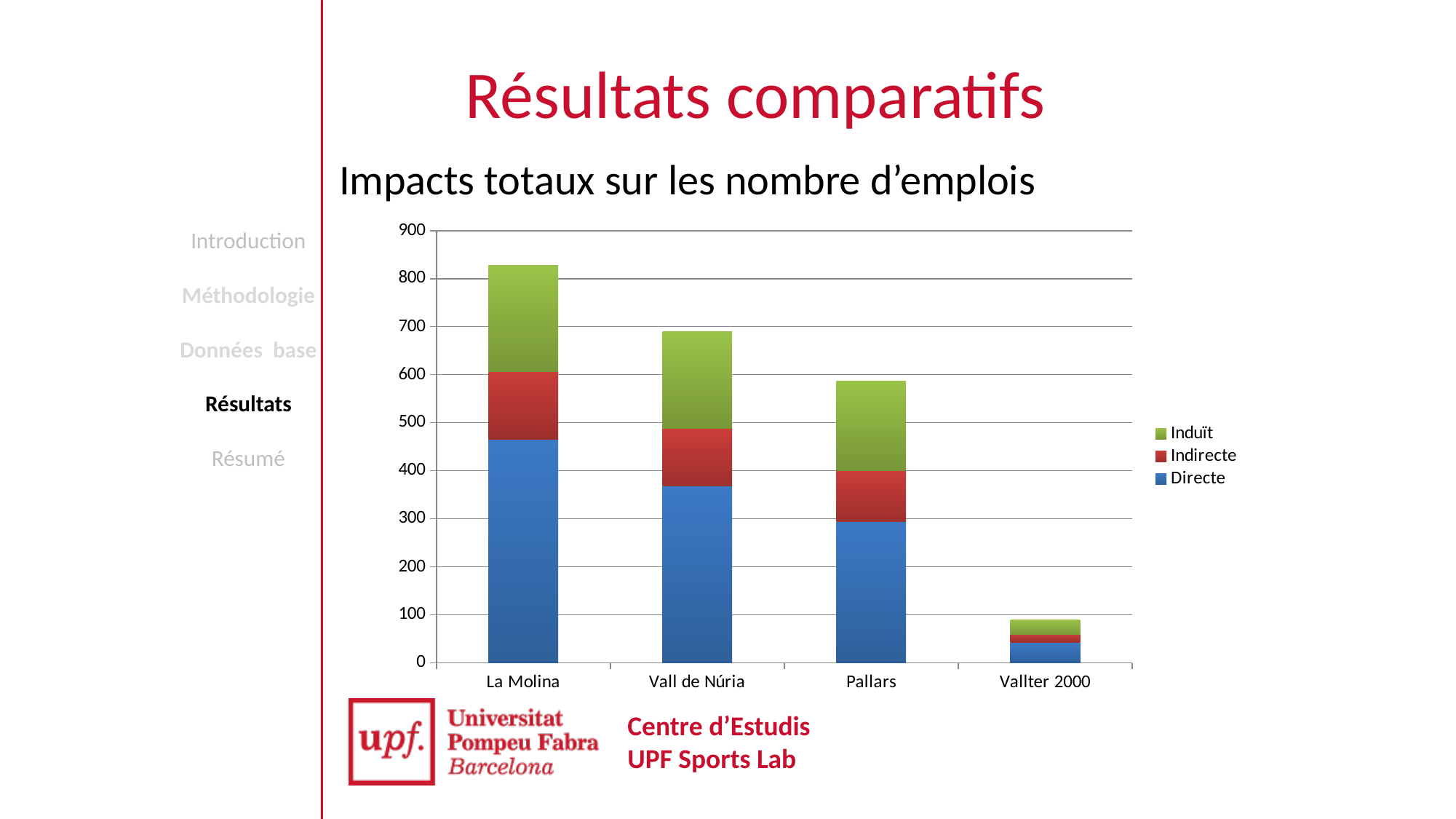
How many series does the legend list? 3 Which series is shown in green in the legend? Induït Is the total bar height for Vallter 2000 greater or less than 200? less Is the Directe value for La Molina greater or less than 400? greater Which category has the shortest stacked bar? Vallter 2000 Do the total bar heights rise or fall from left to right across the x axis? fall Which has a larger total bar, Pallars or Vall de Núria? Vall de Núria Is the total bar height for Vall de Núria greater or less than 600? greater How many categories (ski resorts) are shown on the x axis? 4 Which category has the tallest stacked bar? La Molina What kind of chart is shown on the slide? Stacked bar chart